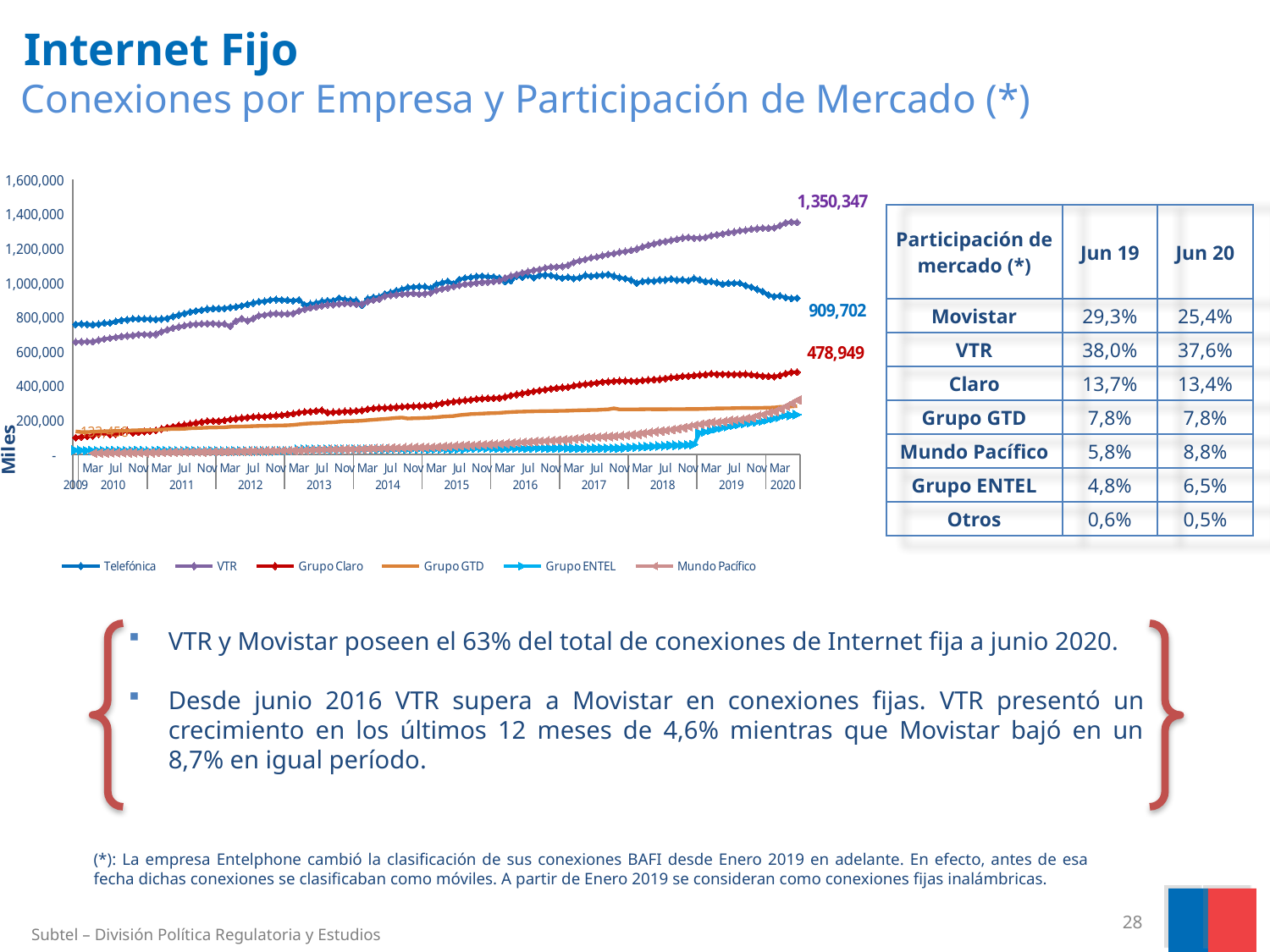
What is the difference between the final labelled values of VTR and Telefónica? 440,645 What is the difference between the final labelled values of Telefónica and Grupo Claro? 430,753 Is the value for Grupo GTD at the end of the chart greater or less than 400,000? less How many series does the chart legend list? 6 At the end of the chart, which is larger: VTR or Telefónica? VTR What is the final labelled value for VTR on the chart? 1,350,347 What kind of chart is shown on the slide? line chart What is the label on the vertical axis of the chart? Miles What is the final labelled value for Telefónica on the chart? 909,702 What is the final labelled value for Grupo Claro on the chart? 478,949 Which series has the highest value at the end of the chart (2020)? VTR Does the VTR line rise or fall from 2009 to 2020? rise